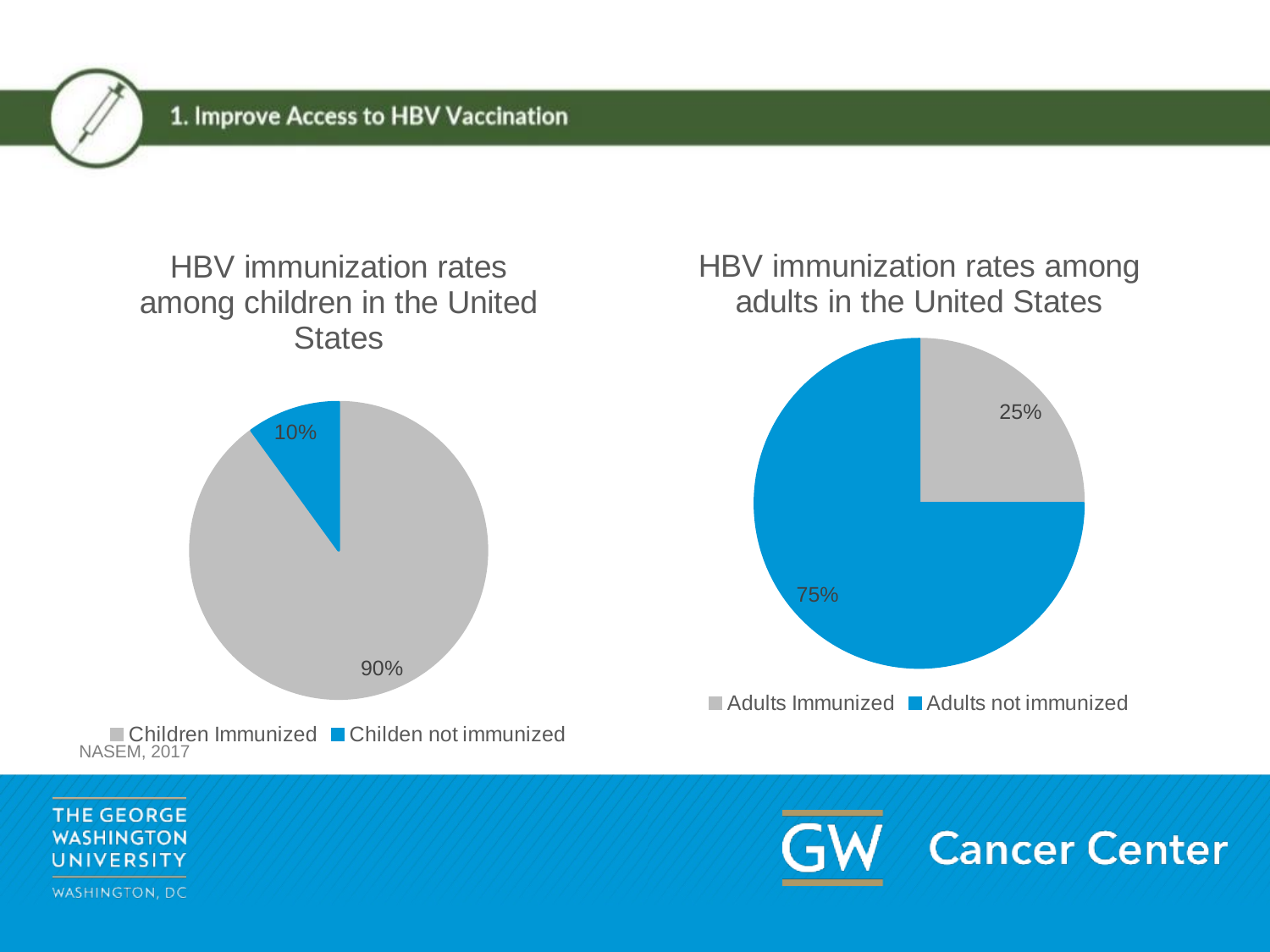
In the chart on the right, which slice is the smallest? Adults Immunized In the chart on the left, which slice is the largest? Children Immunized What type of chart is used in the chart titled 'HBV immunization rates among adults in the United States'? Pie chart In the chart on the right, what colour is the Adults not immunized slice? Blue In the chart titled 'HBV immunization rates among adults in the United States', what percentage of adults are not immunized? 75% In the chart on the right, which is larger: Adults Immunized or Adults not immunized? Adults not immunized In the chart titled 'HBV immunization rates among children in the United States', what percentage of children are not immunized? 10% How many slices does the chart on the left have? 2 In the chart titled 'HBV immunization rates among adults in the United States', what percentage of adults are immunized? 25% In the chart titled 'HBV immunization rates among children in the United States', what percentage of children are immunized? 90% In the chart on the left, what is the difference between the Children Immunized and Childen not immunized slices? 80% In the chart on the right, what is the difference between the Adults not immunized and Adults Immunized slices? 50%